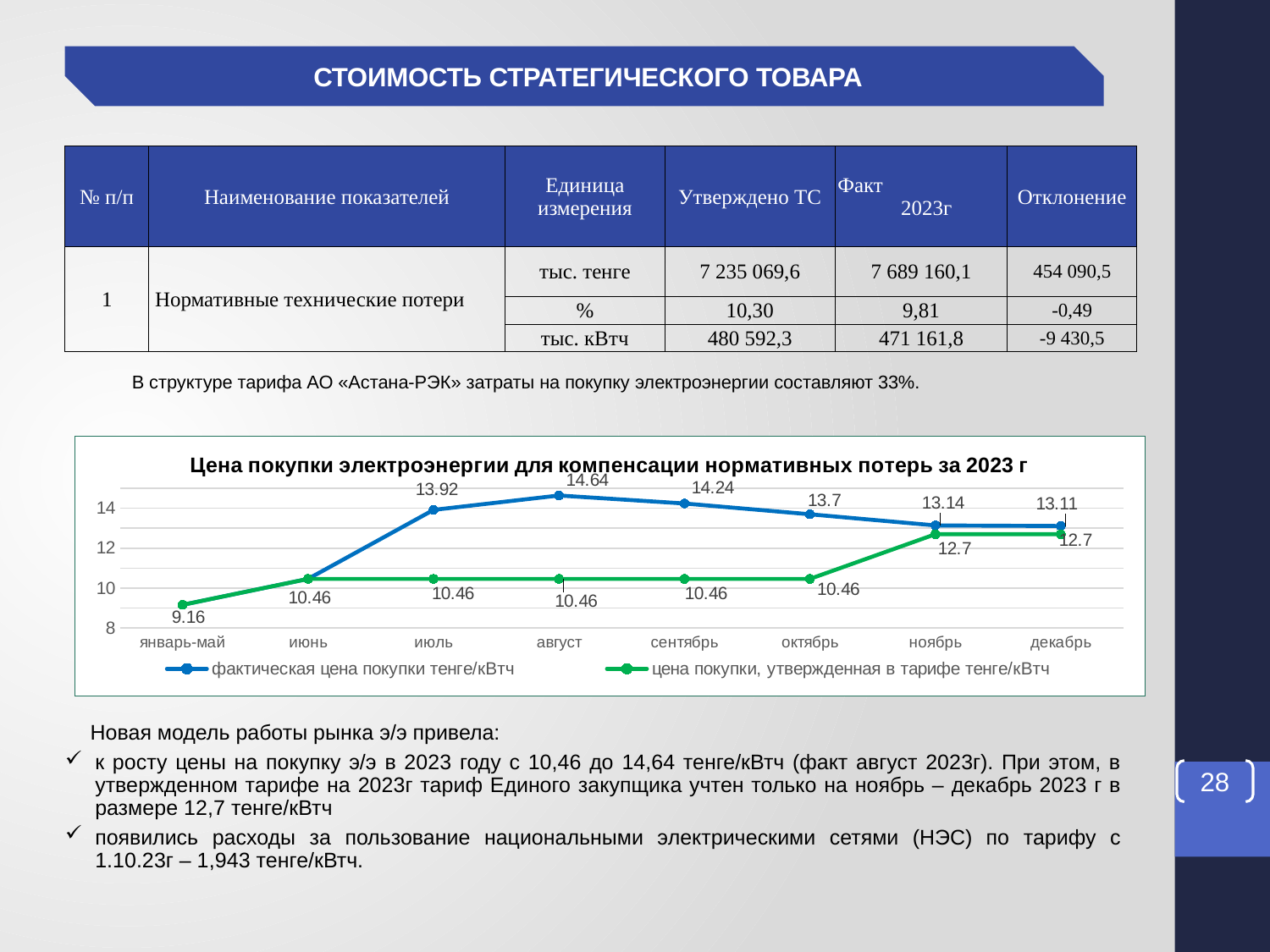
In which category is the фактическая цена покупки lowest? январь-май What is the фактическая цена покупки for июль? 13.92 How many series does the chart legend list? 2 How many categories are shown on the x axis of the chart? 8 What is the title of the chart? Цена покупки электроэнергии для компенсации нормативных потерь за 2023 г Which is larger in декабрь: the фактическая цена покупки or the цена покупки, утвержденная в тарифе? фактическая цена покупки What is the цена покупки, утвержденная в тарифе for ноябрь? 12.7 What kind of chart is shown on the slide? line chart Does the фактическая цена покупки rise or fall from август to декабрь? fall What is the difference between the фактическая цена покупки and the цена покупки, утвержденная в тарифе in август? 4.18 In which month is the фактическая цена покупки highest? август What is the фактическая цена покупки for август? 14.64